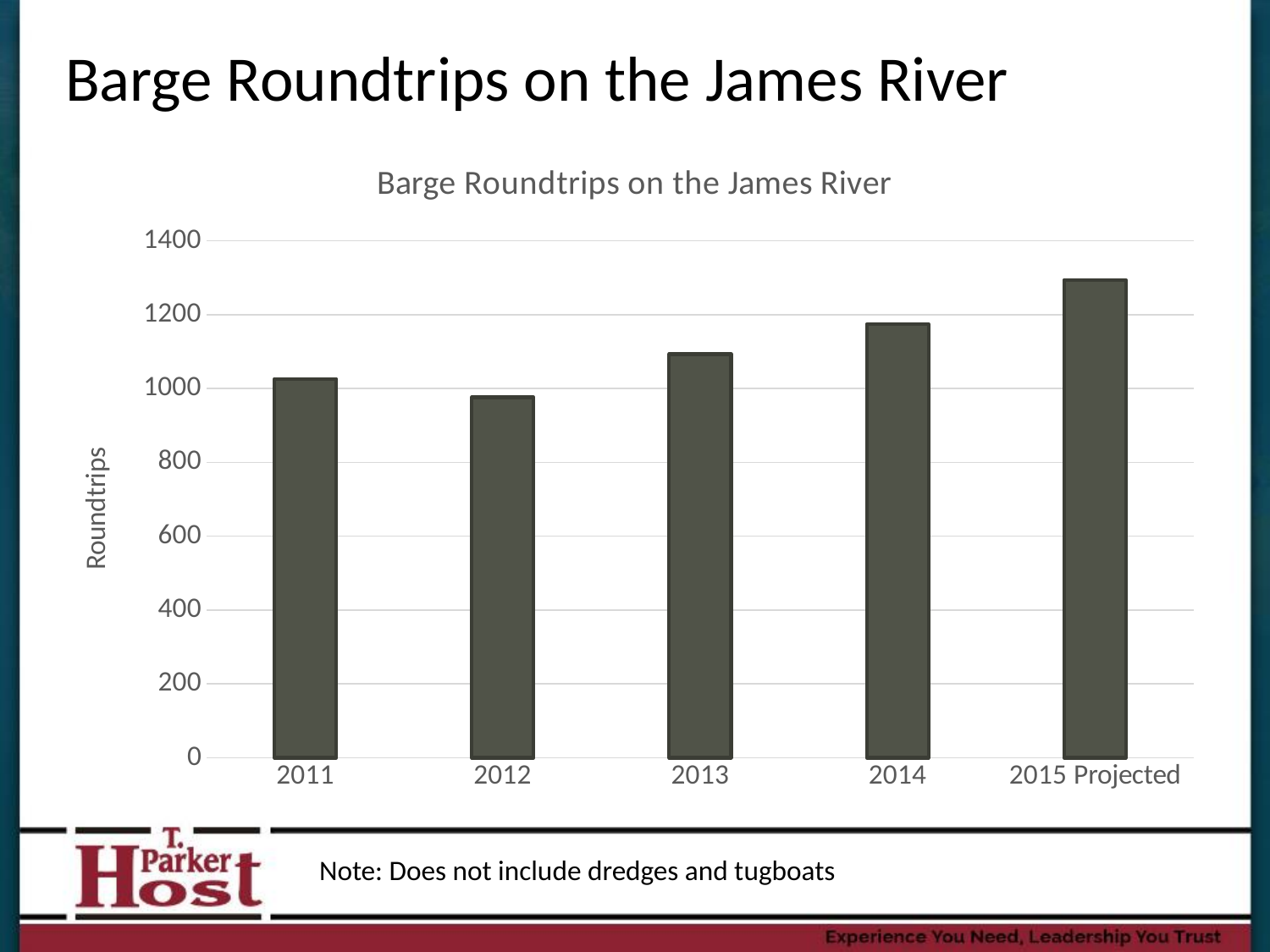
Which year has more barge roundtrips, 2013 or 2014? 2014 How many years (categories) are shown on the x axis of the chart? 5 What is the label on the vertical axis of the chart? Roundtrips Is the value for 2015 Projected greater or less than 1200? greater Is the value for 2012 greater or less than 800? greater Which year has more barge roundtrips, 2011 or 2012? 2011 Is the value for 2014 greater or less than 1200? less Do the barge roundtrips rise or fall from 2012 to 2015 Projected? rise What kind of chart is shown on the slide? bar chart Which year has the highest number of barge roundtrips? 2015 Projected Which year has the lowest number of barge roundtrips? 2012